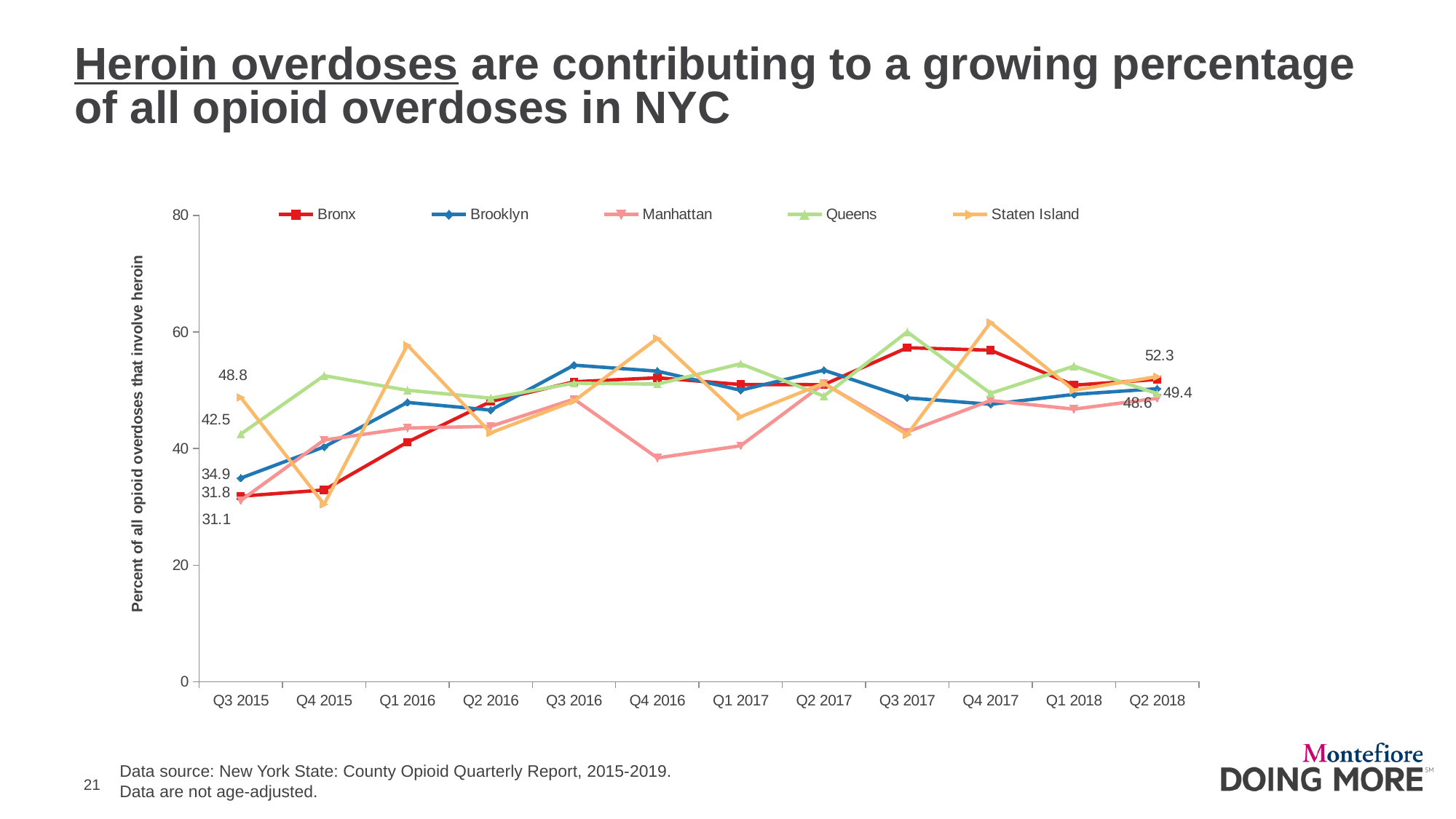
What is the value for Manhattan in Q2 2018? 48.6 What is the value for Staten Island in Q3 2015? 48.8 What is the value for Brooklyn in Q3 2015? 34.9 Which borough has the highest value in Q3 2015? Staten Island What is the value for Queens in Q3 2015? 42.5 What is the difference between the Staten Island and Queens values in Q3 2015? 6.3 What type of chart is shown on the slide? Line chart Is the value for Manhattan in Q4 2016 greater or less than 40? less How many quarters are shown along the x axis? 12 How many series does the legend list? 5 Is the value for Bronx in Q3 2017 greater or less than 50? greater What is the title of the y axis? Percent of all opioid overdoses that involve heroin